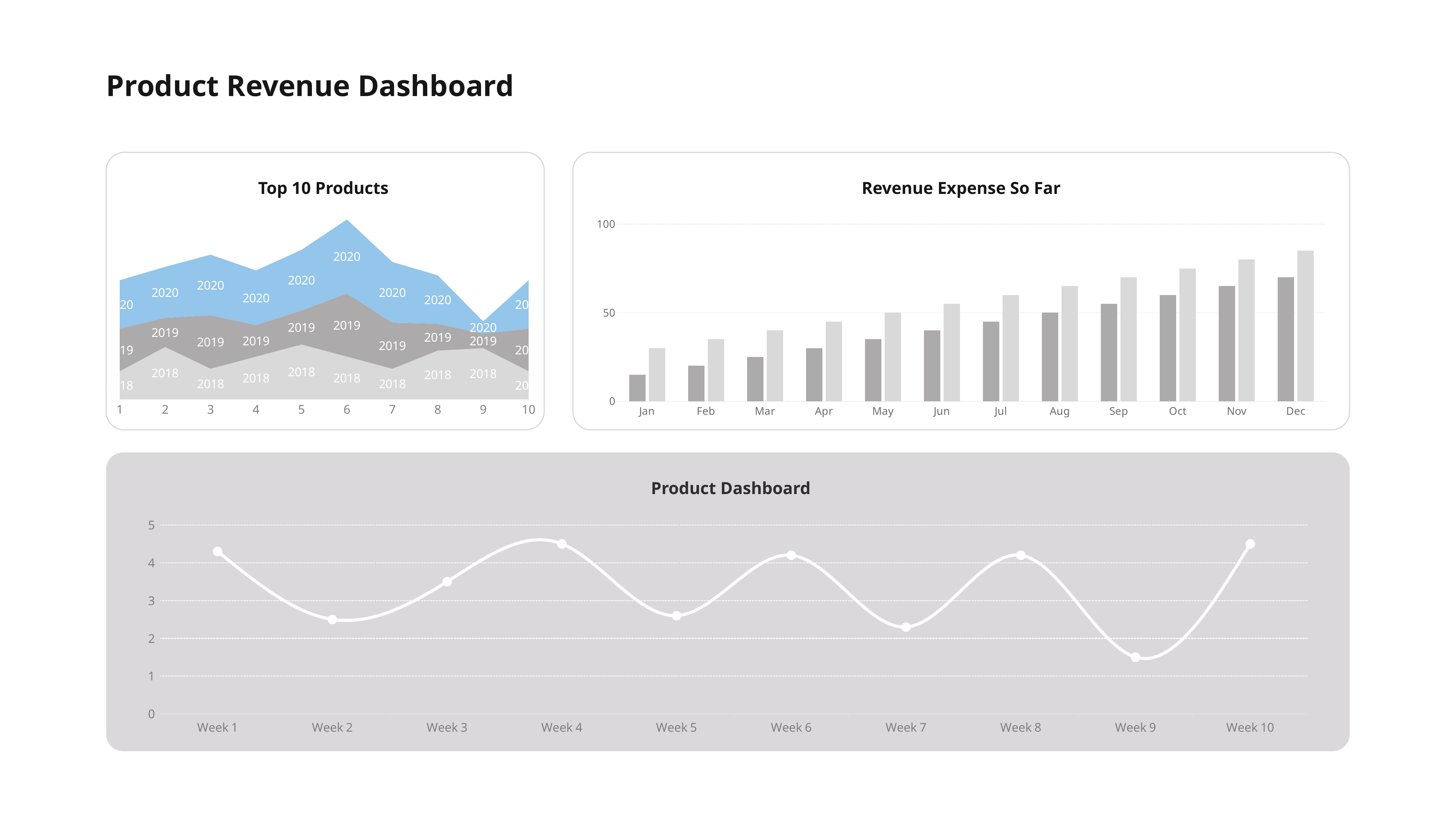
What kind of chart is the 'Product Dashboard' chart? line chart In the 'Revenue Expense So Far' chart, how many months are shown on the x axis? 12 In the 'Revenue Expense So Far' chart, is the dark grey bar for Jan greater or less than 50? less In the 'Product Dashboard' chart, is the value for Week 9 greater or less than 2? less In the 'Product Dashboard' chart, which week has the lowest value? Week 9 What kind of chart is the 'Revenue Expense So Far' chart? bar chart In the 'Top 10 Products' chart, which year's series is shaded blue? 2020 In the 'Revenue Expense So Far' chart, is the light grey bar for Dec greater or less than 50? greater In the 'Revenue Expense So Far' chart, do the bars generally rise or fall from Jan to Dec? rise In the 'Product Dashboard' chart, which is larger, the value for Week 1 or the value for Week 2? Week 1 What kind of chart is the 'Top 10 Products' chart? area chart In the 'Product Dashboard' chart, how many weeks are plotted? 10